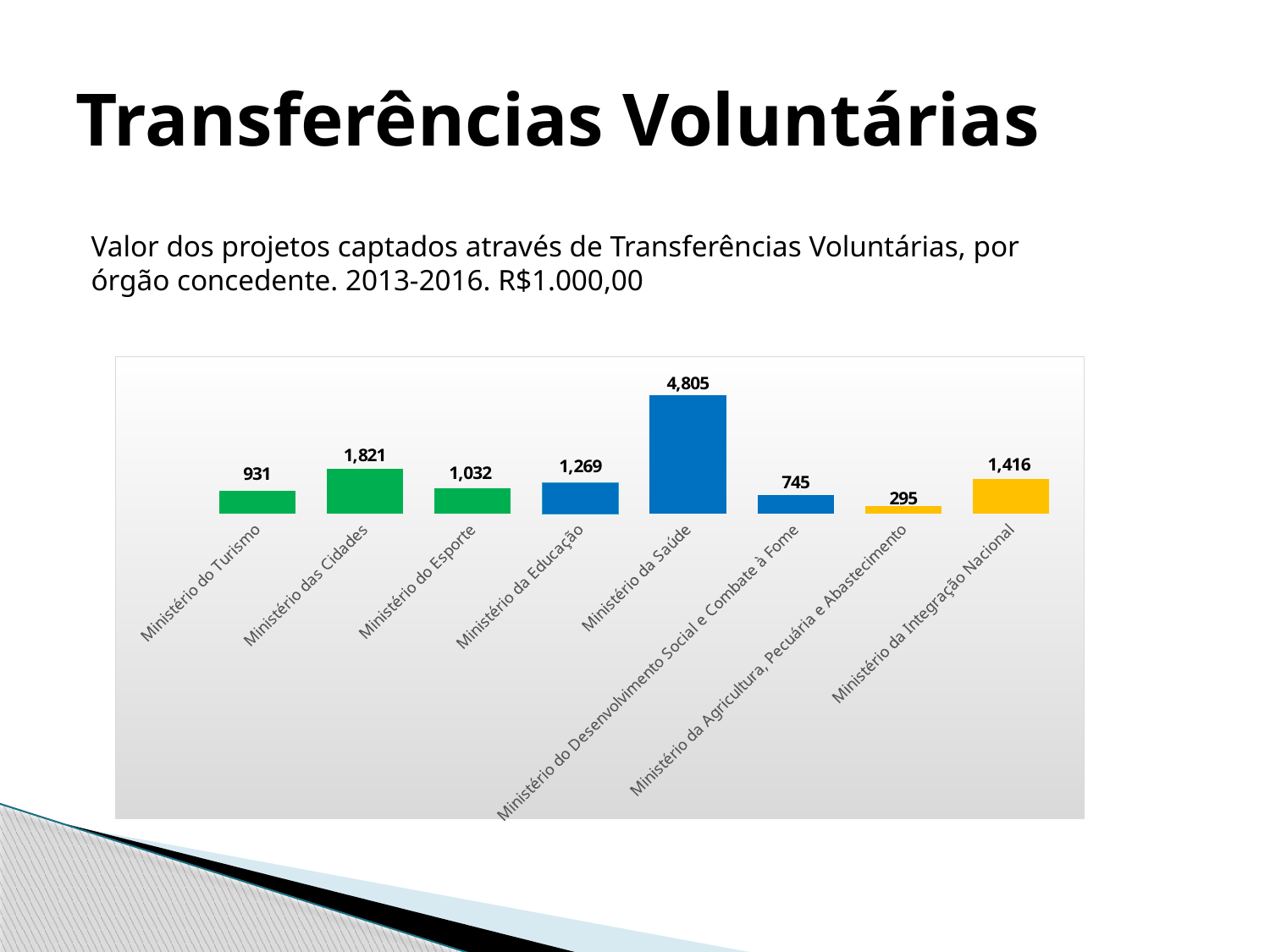
Which category has the lowest value? Ministério da Agricultura, Pecuária e Abastecimento What is the value for Ministério da Saúde? 4,805 How many categories are shown in the chart? 8 Which category has the highest value? Ministério da Saúde What colour is the bar for Ministério da Integração Nacional? Yellow What is the value for Ministério da Agricultura, Pecuária e Abastecimento? 295 What kind of chart is shown on the slide? Bar chart Which is larger, the value for Ministério da Educação or the value for Ministério do Desenvolvimento Social e Combate à Fome? Ministério da Educação What is the difference between the values for Ministério das Cidades and Ministério do Esporte? 789 What is the difference between the values for Ministério da Saúde and Ministério da Integração Nacional? 3,389 What is the value for Ministério do Turismo? 931 What is the value for Ministério da Integração Nacional? 1,416